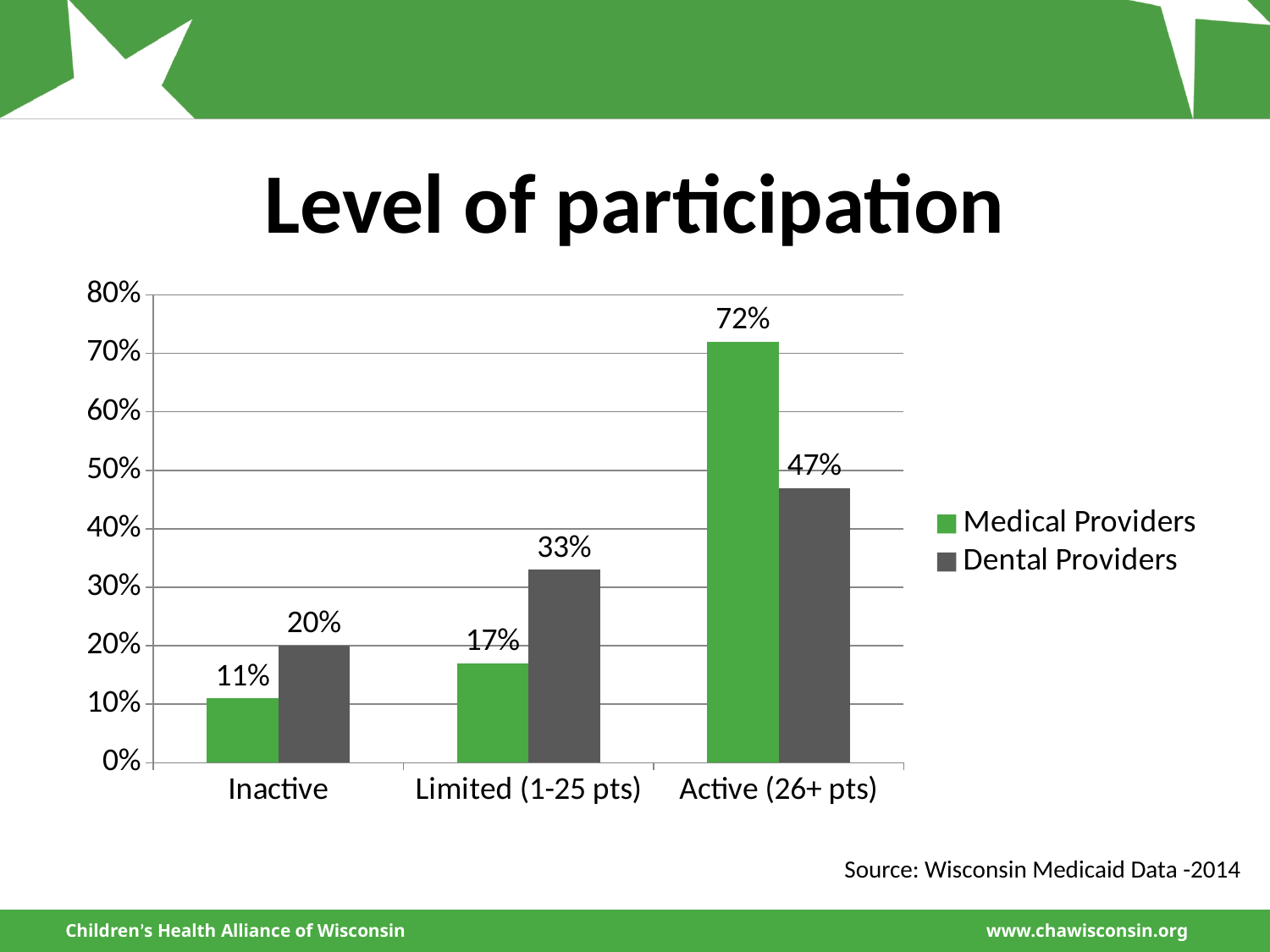
What is the title of the chart? Level of participation What is the value for Dental Providers in the Limited (1-25 pts) category? 33% How many categories are shown on the x axis? 3 What kind of chart is shown on the slide? Bar chart Which category has the highest value for Medical Providers? Active (26+ pts) What is the difference between Medical Providers and Dental Providers in the Active (26+ pts) category? 25% How many series does the legend list? 2 What is the value for Dental Providers in the Inactive category? 20% In the Limited (1-25 pts) category, which series has the larger value, Medical Providers or Dental Providers? Dental Providers Do the Medical Providers values rise or fall from Inactive to Active (26+ pts)? Rise What is the value for Medical Providers in the Active (26+ pts) category? 72% Which category has the lowest value for Dental Providers? Inactive